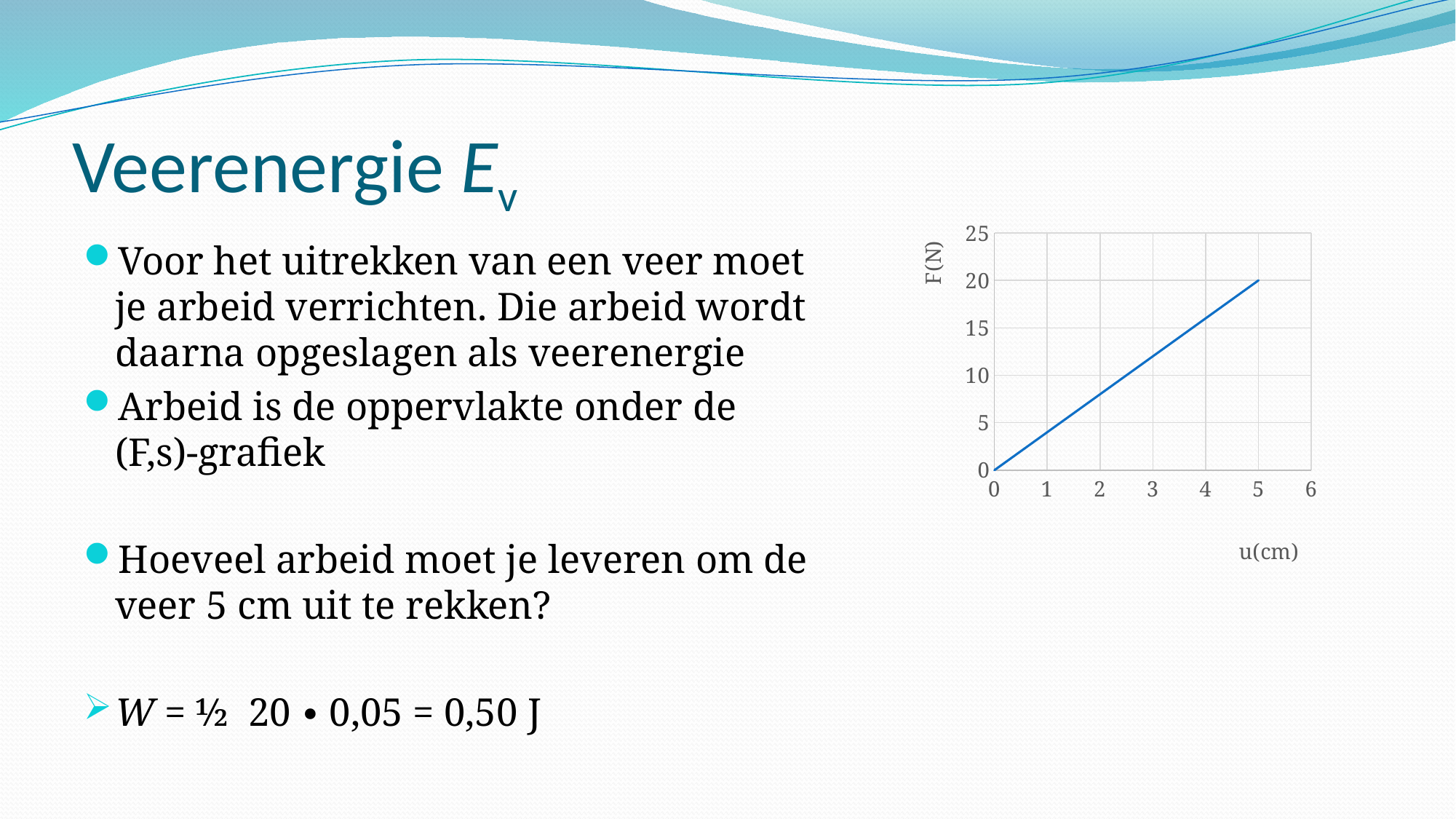
What is the label of the vertical axis of the chart? F (N) What is the value of F (N) at u = 0 cm? 0 Is the value of F at u = 3 cm greater or less than 10? greater Is the value of F at u = 1 cm greater or less than 5? less What is the highest value shown on the vertical axis of the chart? 25 What is the value of F (N) where the line ends, at u = 5 cm? 20 Does the force F rise or fall as u increases along the x axis? rise Which is larger, the value of F at u = 2 cm or at u = 4 cm? u = 4 cm What is the label of the horizontal axis of the chart? u(cm) What kind of chart is shown on the slide? line chart Is the value of F at u = 4 cm greater or less than 15? greater